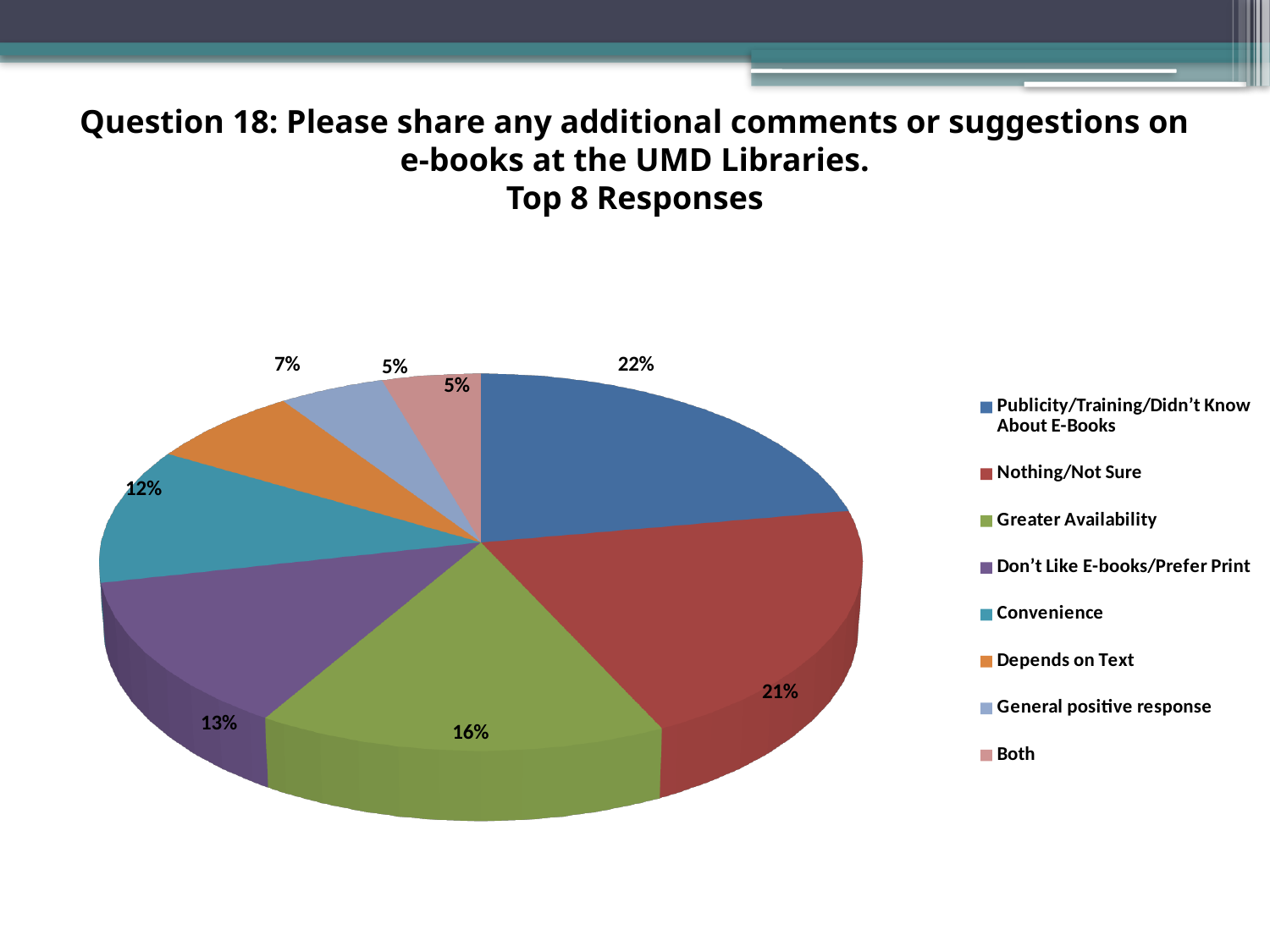
What share of responses is Don't Like E-books/Prefer Print? 13% What share of responses is Convenience? 12% What share of responses is Publicity/Training/Didn't Know About E-Books? 22% What kind of chart is shown on the slide? pie chart What share of responses is Greater Availability? 16% What is the difference in percentage points between Nothing/Not Sure and Greater Availability? 5 What is the combined share of General positive response and Both? 10% Which is larger, the share for Convenience or the share for Depends on Text? Convenience What share of responses is Depends on Text? 7% Which response category has the largest share of the pie? Publicity/Training/Didn't Know About E-Books What colour is the slice for Nothing/Not Sure? red How many response categories does the legend list? 8